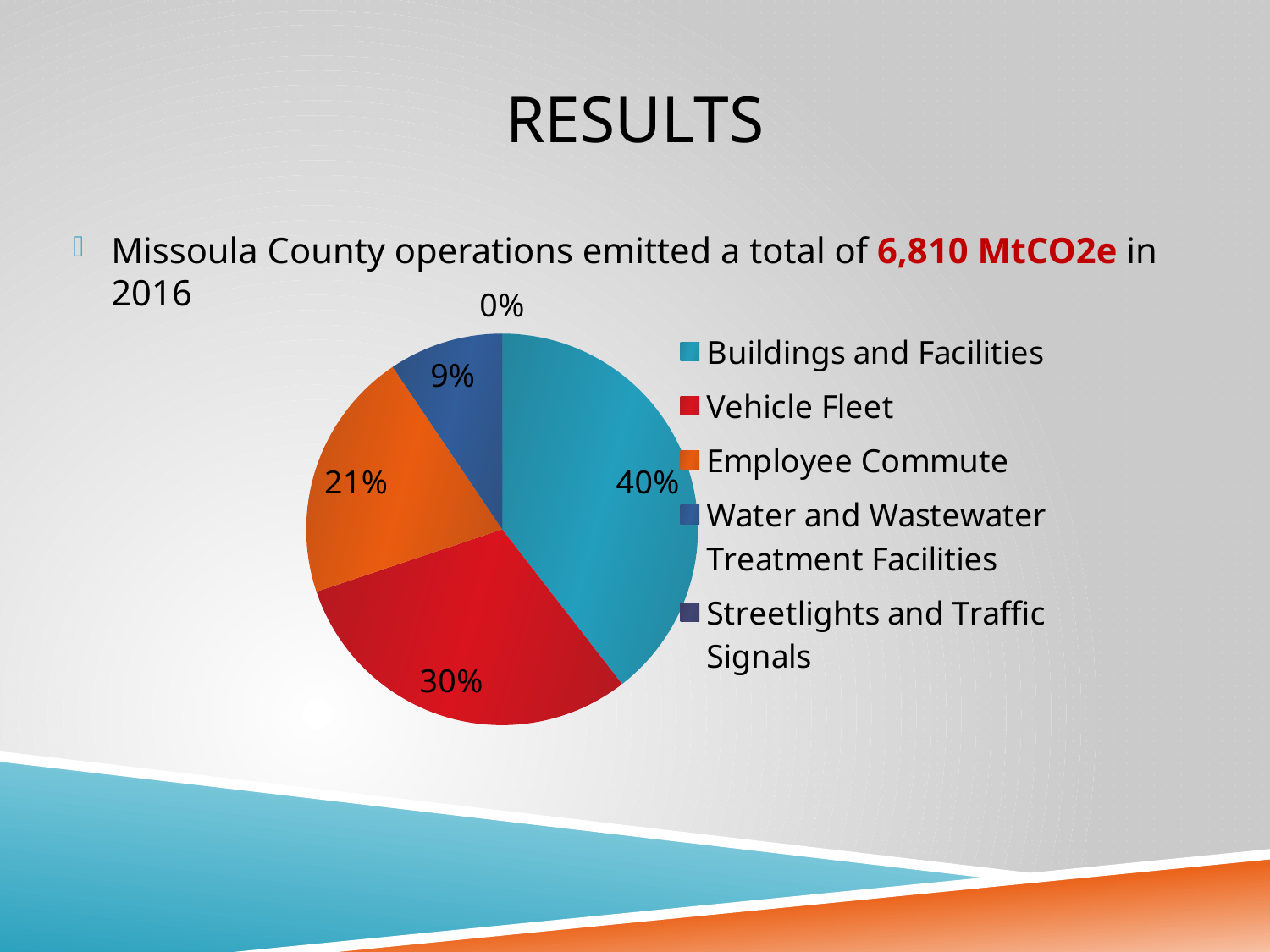
What share of the pie does Water and Wastewater Treatment Facilities account for? 9% What share of the pie does Streetlights and Traffic Signals account for? 0% What colour is the Vehicle Fleet slice? red What kind of chart is shown on the slide? pie chart Which category has the smallest slice of the pie? Streetlights and Traffic Signals What share of the pie does Buildings and Facilities account for? 40% What is the difference in percentage points between the Buildings and Facilities slice and the Vehicle Fleet slice? 10 Which category has the largest slice of the pie? Buildings and Facilities How many categories does the legend list? 5 Which is larger, the Employee Commute slice or the Water and Wastewater Treatment Facilities slice? Employee Commute